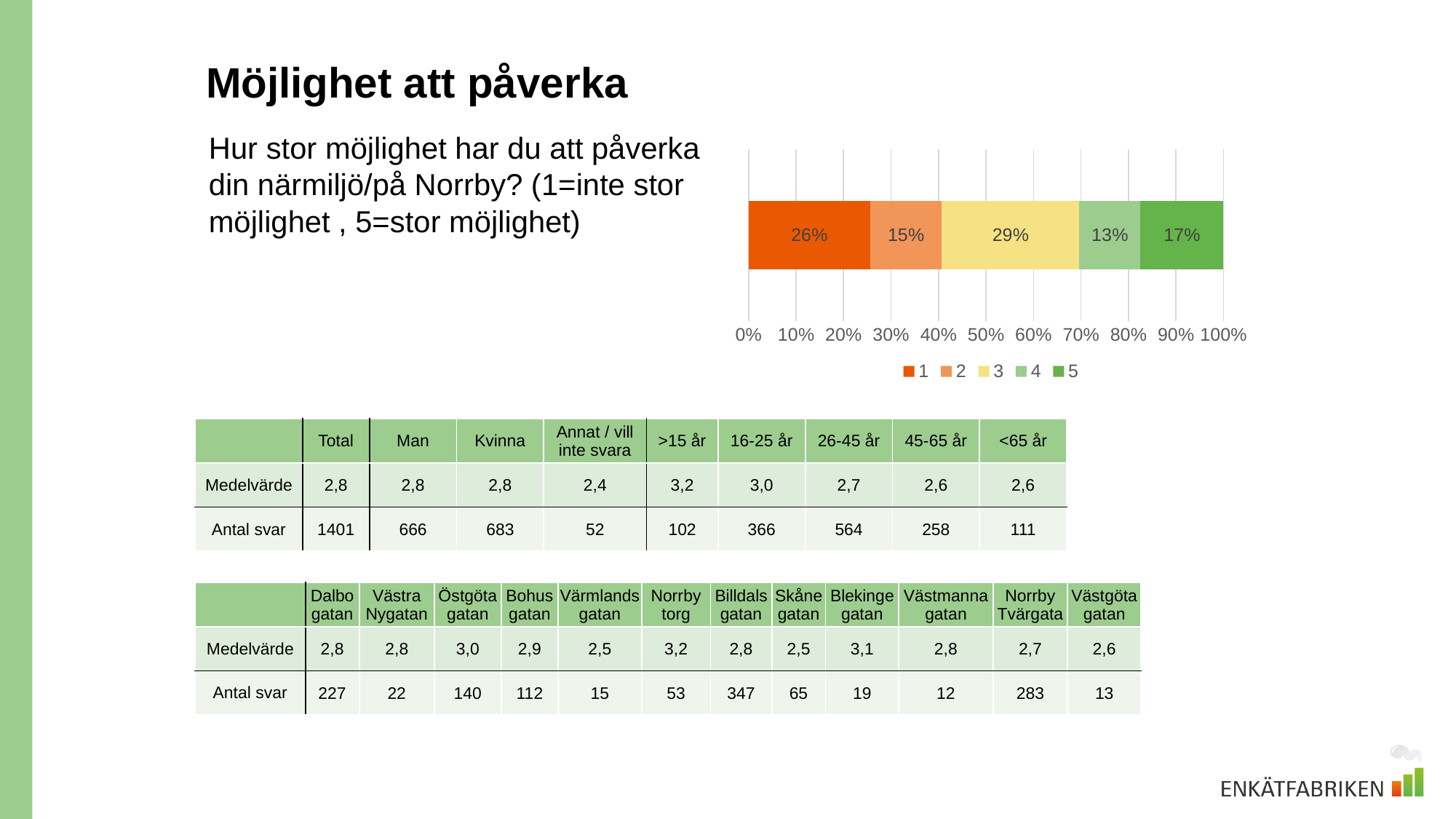
What colour is the segment for answer option 1 in the chart? orange-red What percentage of respondents answered 3? 29% What percentage of respondents answered 2? 15% Which answer option has the largest share in the bar? 3 What percentage of respondents answered 1 (inte stor möjlighet)? 26% What is the combined share of respondents who answered 4 or 5? 30% What kind of chart is shown on the slide? stacked bar chart How many series does the chart legend list? 5 Which is larger, the share answering 2 or the share answering 4? 2 Which answer option has the smallest share in the bar? 4 What is the difference between the share answering 1 and the share answering 5? 9% What percentage of respondents answered 5 (stor möjlighet)? 17%